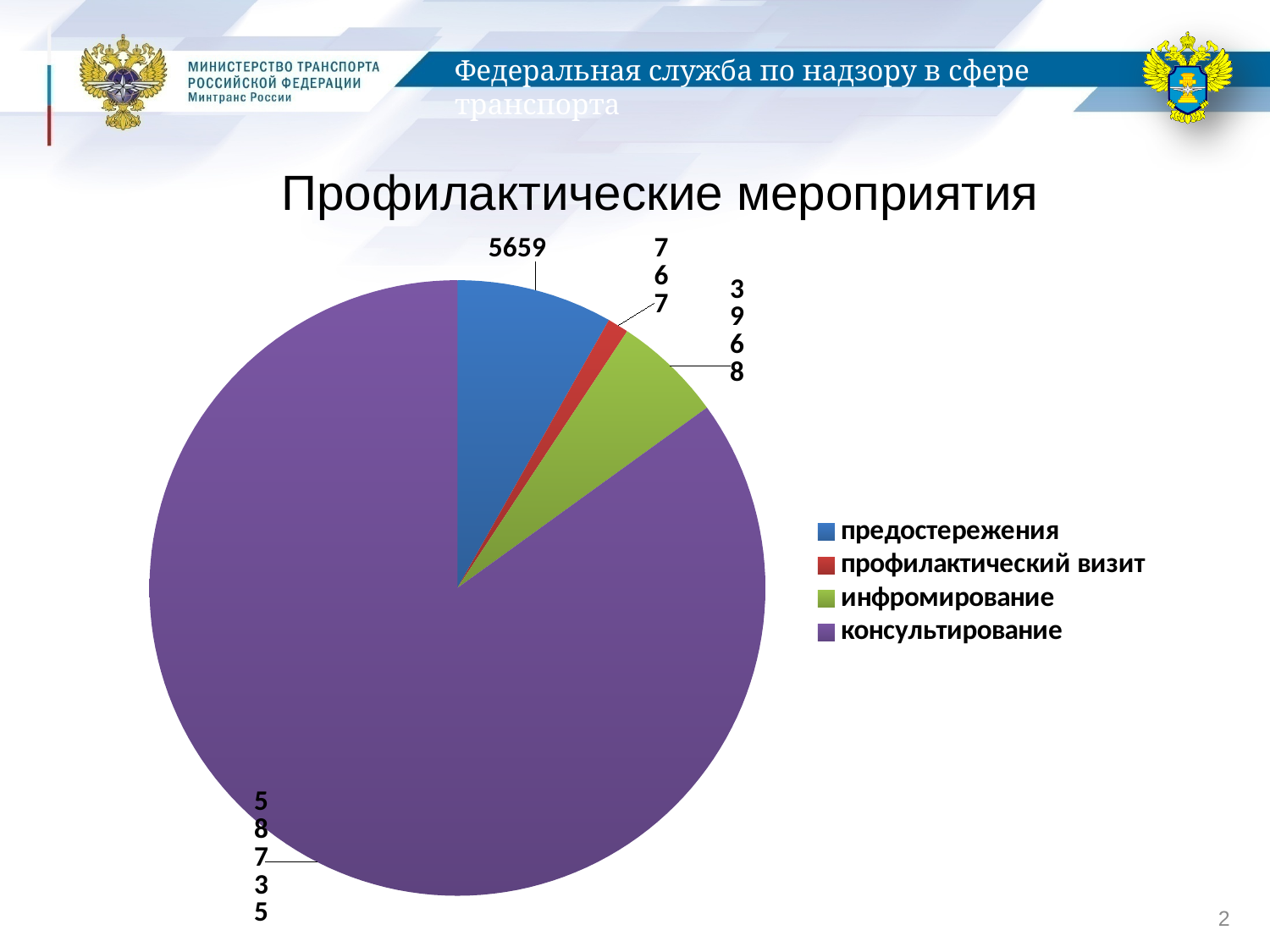
What is the value for консультирование? 58735 What kind of chart is shown on the slide? pie chart What is the value for предостережения? 5659 Which category has the largest slice of the pie? консультирование What is the title of the chart? Профилактические мероприятия Which is larger, предостережения or инфромирование? предостережения What is the value for инфромирование? 3968 How many slices does the pie chart have? 4 Which category has the smallest slice of the pie? профилактический визит What is the difference between the values for предостережения and профилактический визит? 4892 What is the value for профилактический визит? 767 How many entries does the legend list? 4